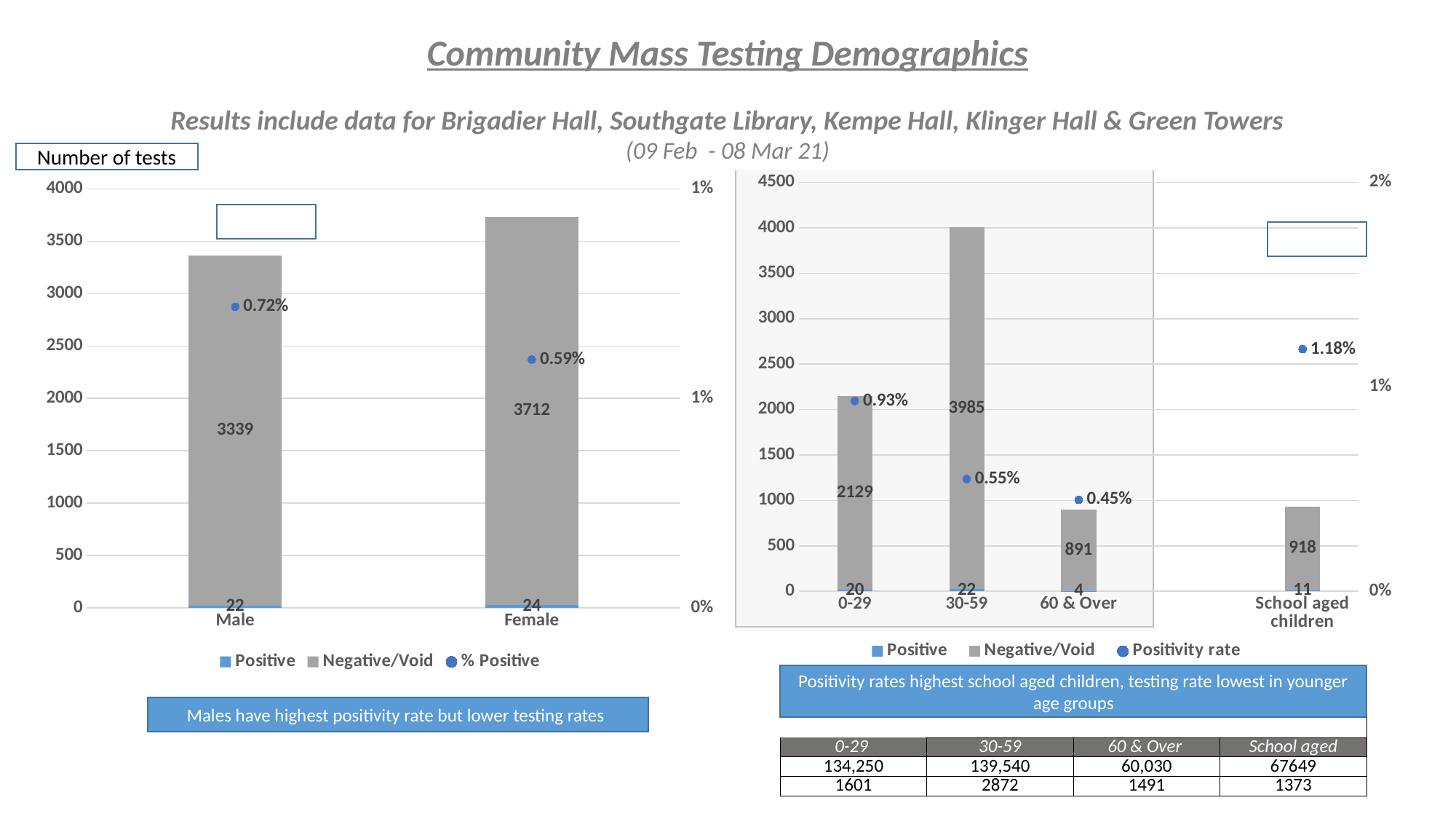
In the left chart (Male/Female), what is the % Positive value for Female? 0.59% In the right chart (age groups), what is the Negative/Void value for 30-59? 3985 In the right chart (age groups), which age group has the lowest Positivity rate? 60 & Over In the left chart (Male/Female), what is the Negative/Void value for Male? 3339 In the right chart (age groups), which age group has the highest Negative/Void value? 30-59 In the left chart (Male/Female), what is the total of the stacked bar for Male (Positive plus Negative/Void)? 3361 In the left chart (Male/Female), what is the difference between the Negative/Void values for Female and Male? 373 In the left chart (Male/Female), what is the Positive value for Female? 24 In the right chart (age groups), what is the Positivity rate for School aged children? 1.18% In the right chart (age groups), how many age group categories are shown on the x axis? 4 In the right chart (age groups), what is the total of the stacked bar for 60 & Over (Positive plus Negative/Void)? 895 In the left chart (Male/Female), how many series does the legend list? 3